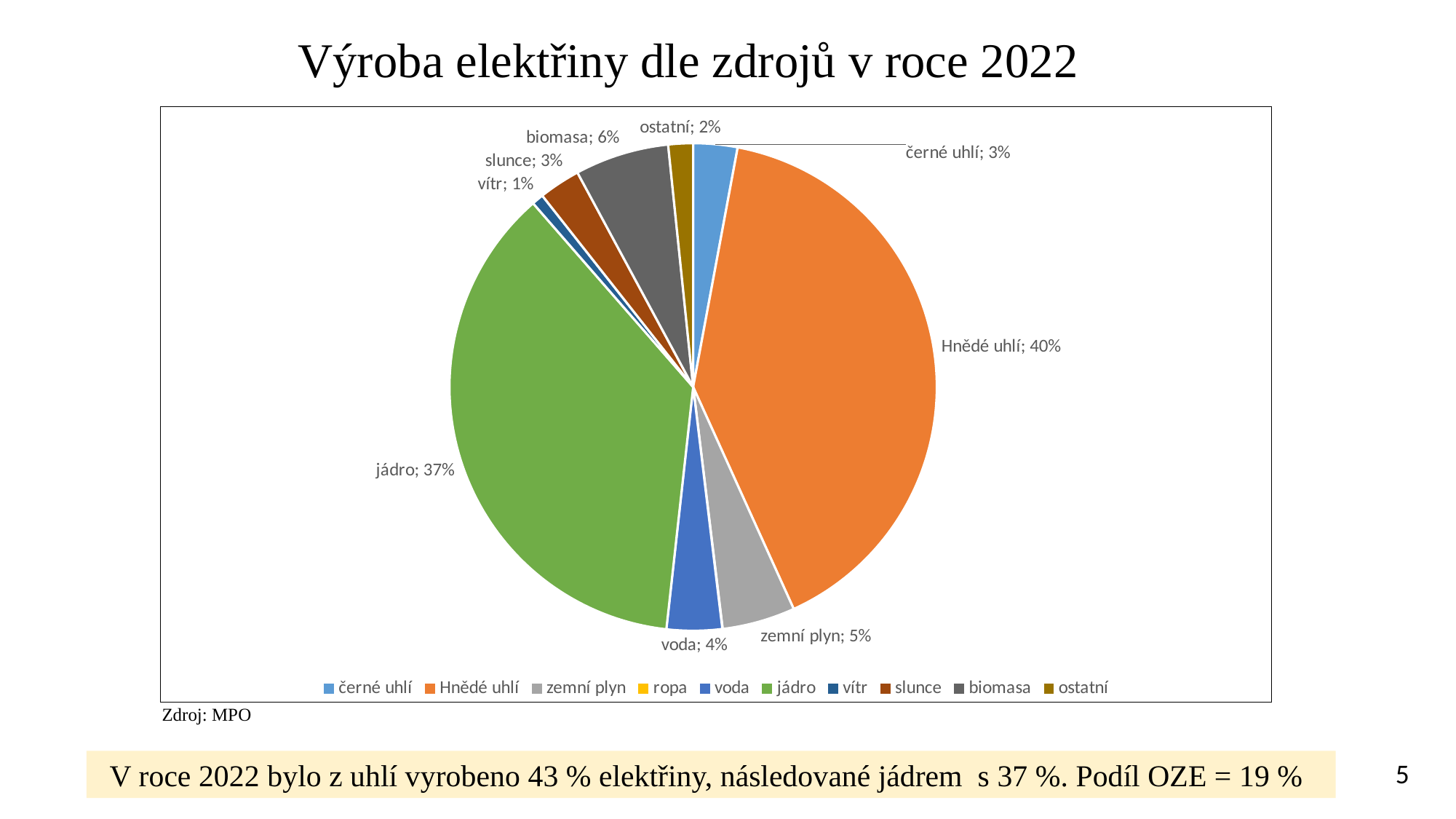
What type of chart is shown on the slide? pie chart What is the combined share of černé uhlí and Hnědé uhlí? 43% Which labelled source has the smallest share in the pie chart? vítr What is the share of Hnědé uhlí in the pie chart? 40% What is the share of jádro in the pie chart? 37% What is the difference in percentage points between Hnědé uhlí and jádro? 3 What is the share of biomasa in the pie chart? 6% What is the title of the chart on the slide? Výroba elektřiny dle zdrojů v roce 2022 How many entries does the legend of the pie chart list? 10 Which has a larger share, zemní plyn or voda? zemní plyn Which source has the largest share in the pie chart? Hnědé uhlí What is the share of vítr in the pie chart? 1%